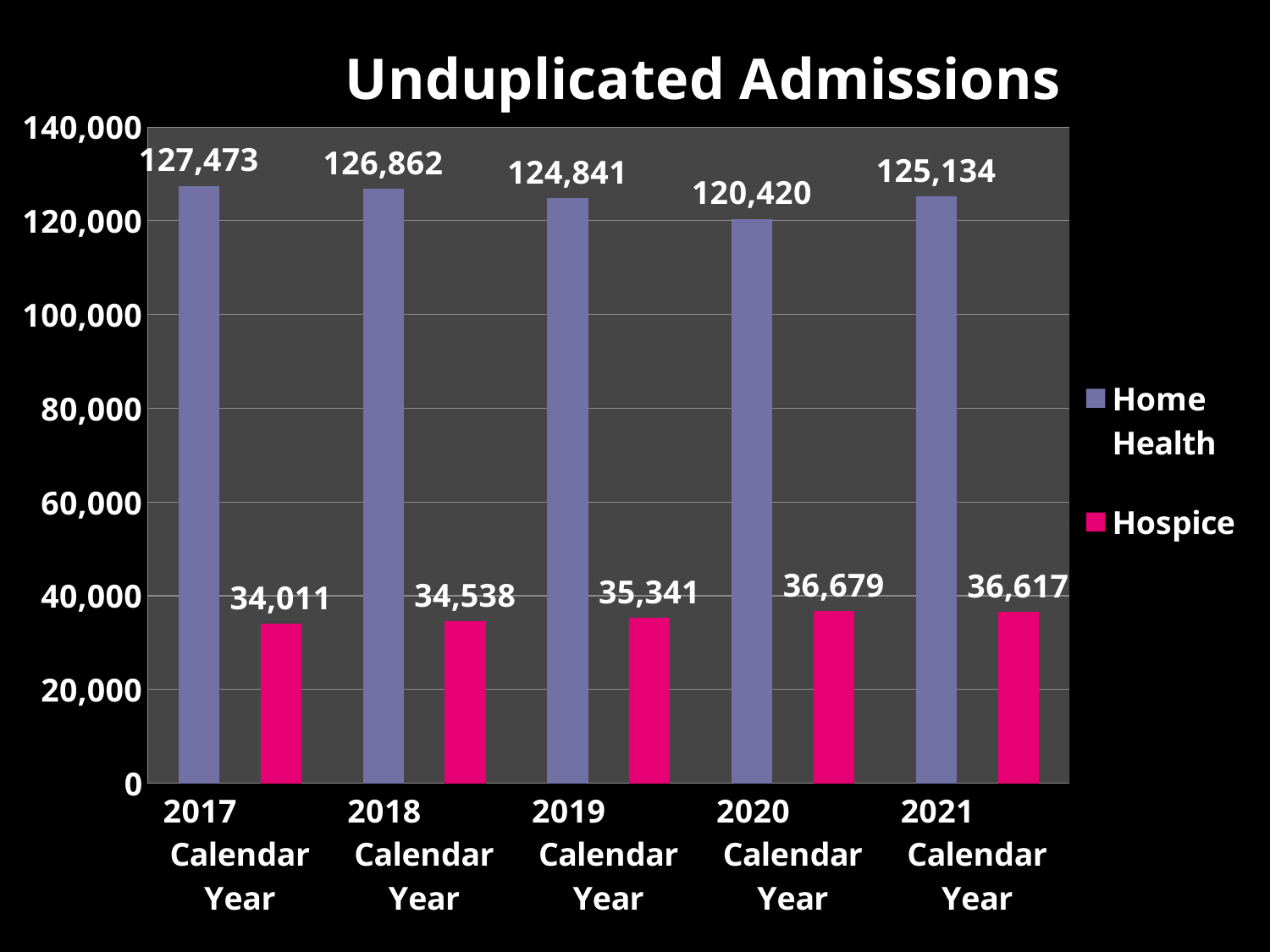
How many calendar years are shown on the x axis? 5 Which calendar year has the highest Home Health admissions? 2017 Calendar Year Which calendar year has the lowest Home Health admissions? 2020 Calendar Year How many series does the legend list? 2 What is the difference between Home Health and Hospice admissions in the 2019 Calendar Year? 89,500 What is the Home Health value for the 2017 Calendar Year? 127,473 Which calendar year has the lowest Hospice admissions? 2017 Calendar Year What is the Hospice value for the 2020 Calendar Year? 36,679 What is the Home Health value for the 2021 Calendar Year? 125,134 What kind of chart is shown on the slide? Bar chart Is the Home Health value for the 2020 Calendar Year greater or less than 120,000? greater What is the difference in Hospice admissions between the 2018 and 2017 Calendar Years? 527